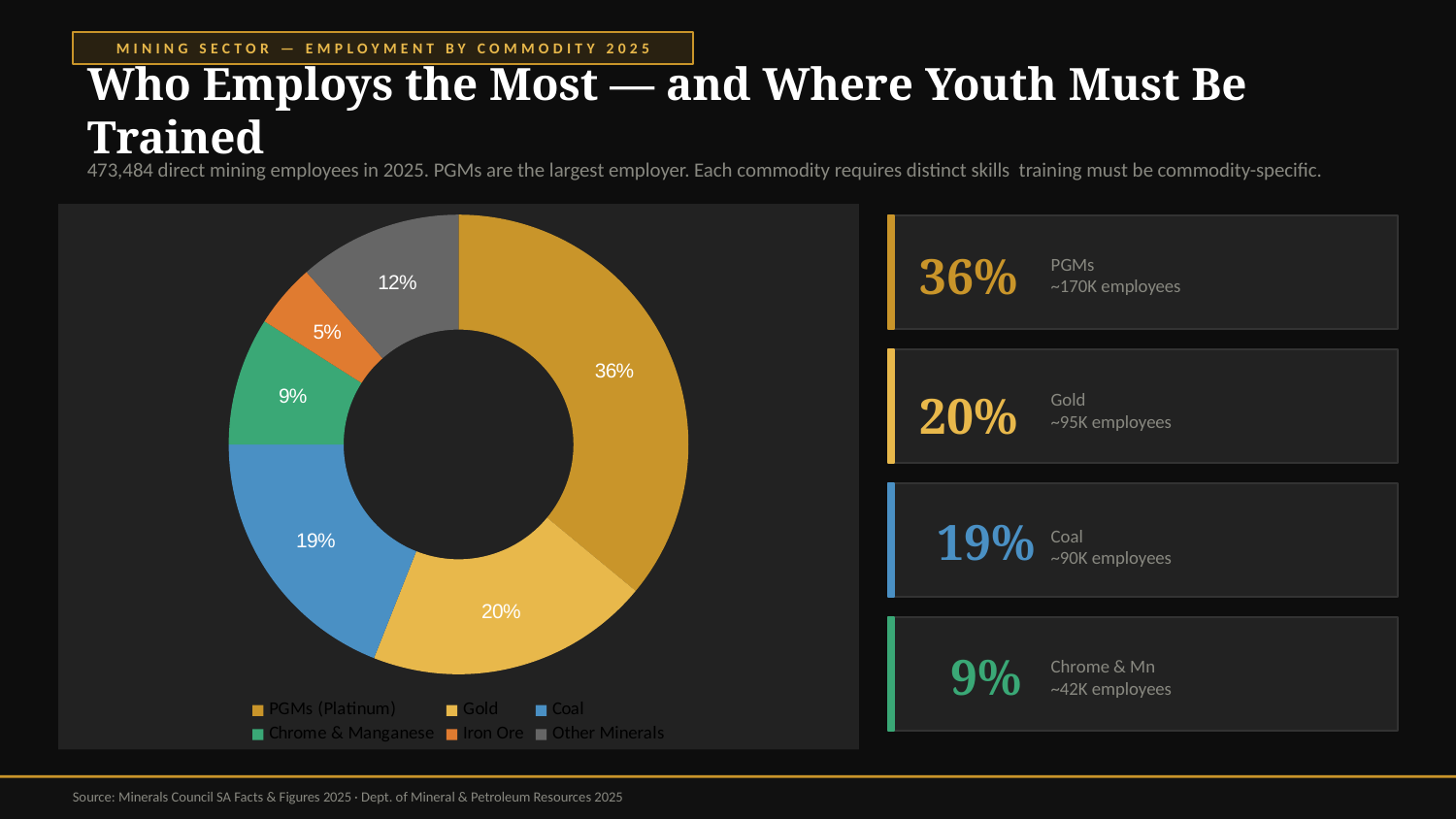
What share of the pie does Other Minerals hold? 12% What is the difference in percentage points between the PGMs (Platinum) slice and the Gold slice? 16 Which commodity has the largest slice of the pie? PGMs (Platinum) Which slice is larger, Other Minerals or Chrome & Manganese? Other Minerals How many categories does the pie chart show? 6 What share of the pie does PGMs (Platinum) hold? 36% What kind of chart is shown on the slide? Doughnut chart What share of the pie does Iron Ore hold? 5% Which commodity has the smallest slice of the pie? Iron Ore